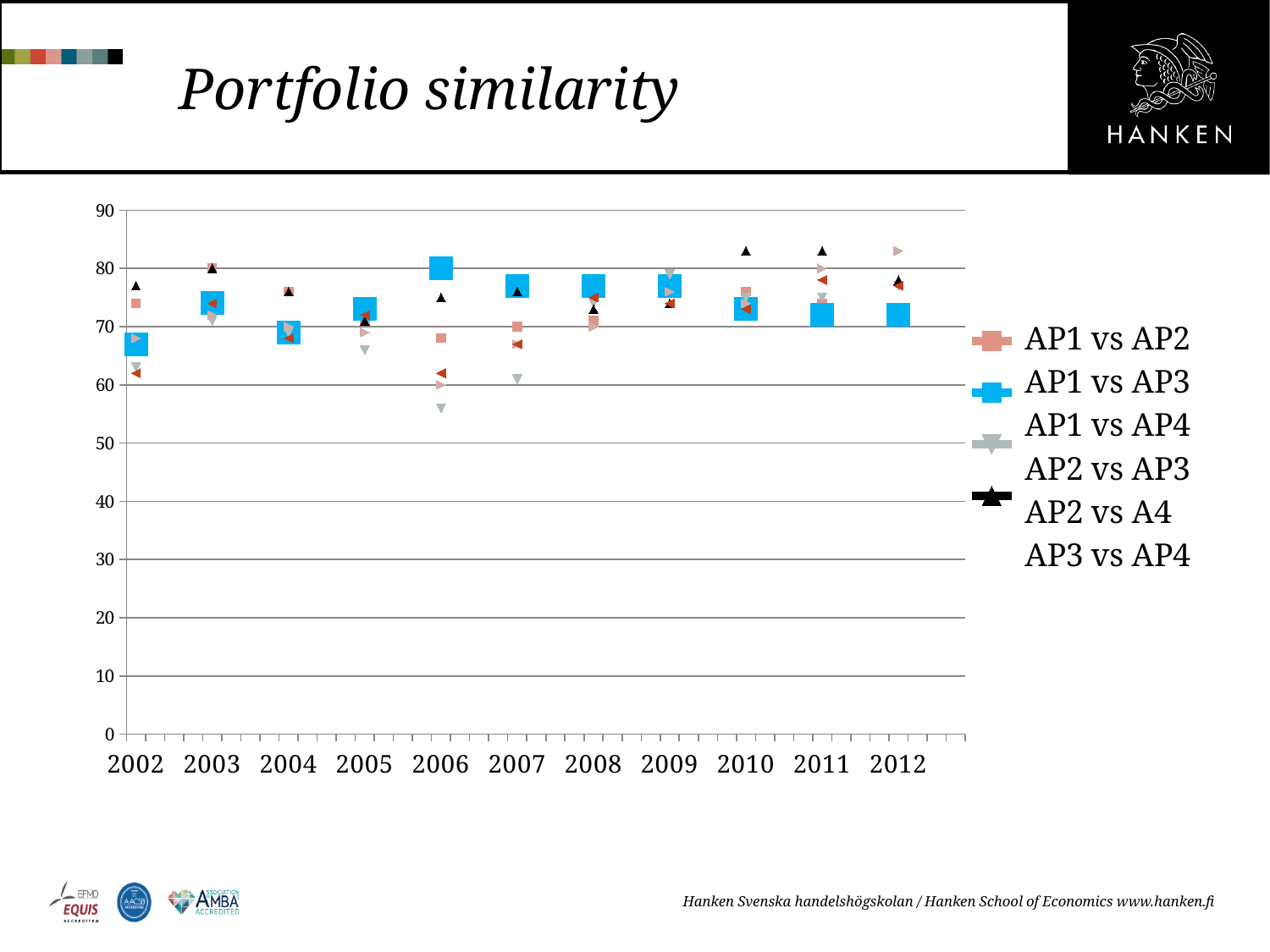
Is the value for AP1 vs AP3 in 2002 greater or less than 70? less What is the title of the slide containing the chart? Portfolio similarity Is the value for AP1 vs AP2 in 2006 greater or less than 70? less What kind of chart is shown on the slide? scatter chart Which series has the highest value in 2010? AP2 vs AP3 Is the value for AP1 vs AP4 in 2006 greater or less than 60? less How many series does the legend list? 6 Which series has the lowest value in 2006? AP1 vs AP4 How many years are shown on the x axis? 11 Which series is represented by the large blue square markers? AP1 vs AP3